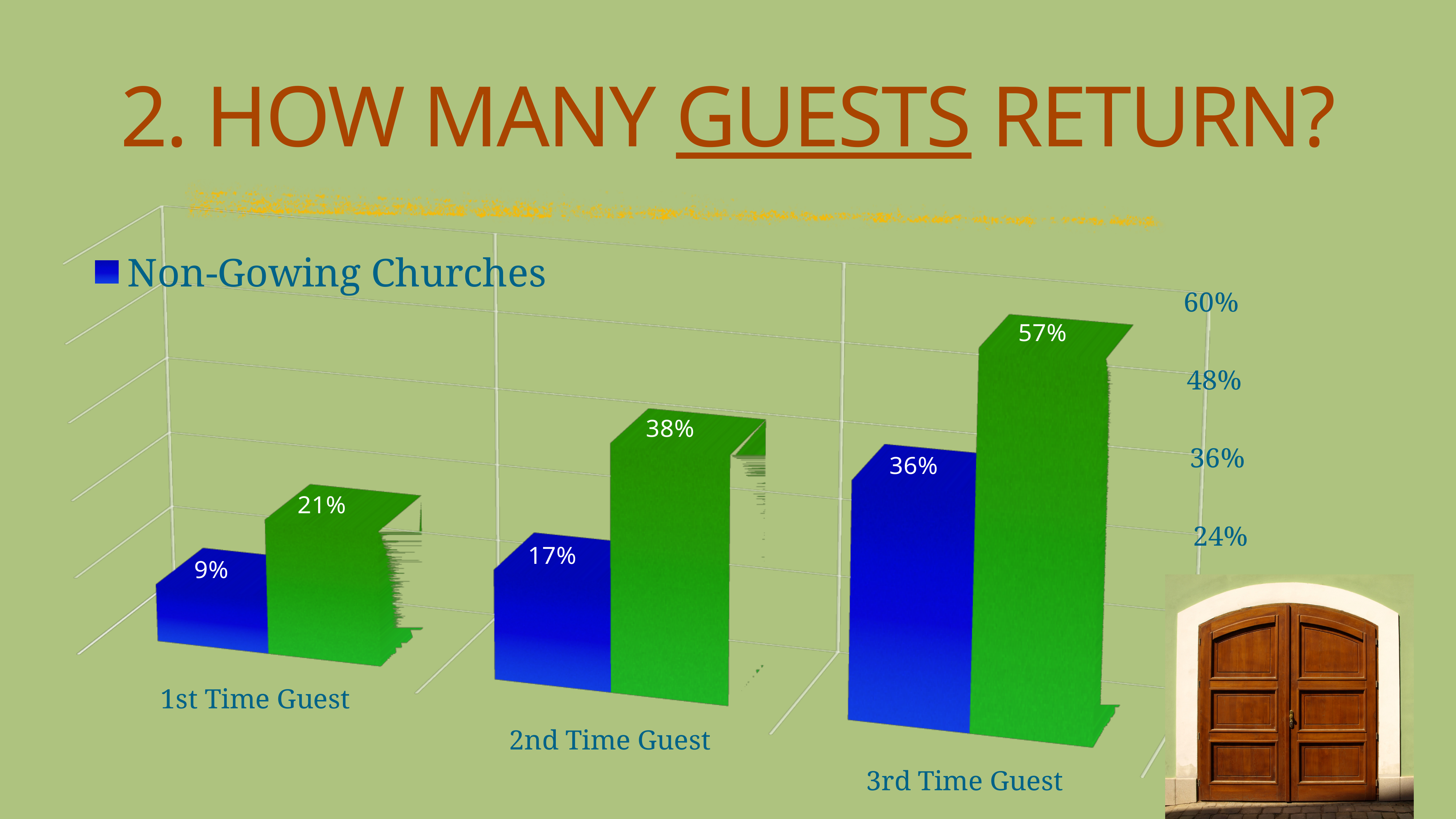
Which category has the highest value for Non-Gowing Churches? 3rd Time Guest Which is larger for 3rd Time Guest: the green bar or the Non-Gowing Churches bar? the green bar How many guest categories are shown on the x axis? 3 Do the Non-Gowing Churches values rise or fall from 1st Time Guest to 3rd Time Guest? rise What kind of chart is shown on the slide? bar chart What is the value for Non-Gowing Churches for 1st Time Guest? 9% What is the value of the green bar for 1st Time Guest? 21% What is the value for Non-Gowing Churches for 2nd Time Guest? 17% What is the value for Non-Gowing Churches for 3rd Time Guest? 36% What is the value of the green bar for 3rd Time Guest? 57% Which category has the lowest value among the green bars? 1st Time Guest What is the difference between the green bar and the Non-Gowing Churches bar for 2nd Time Guest? 21%